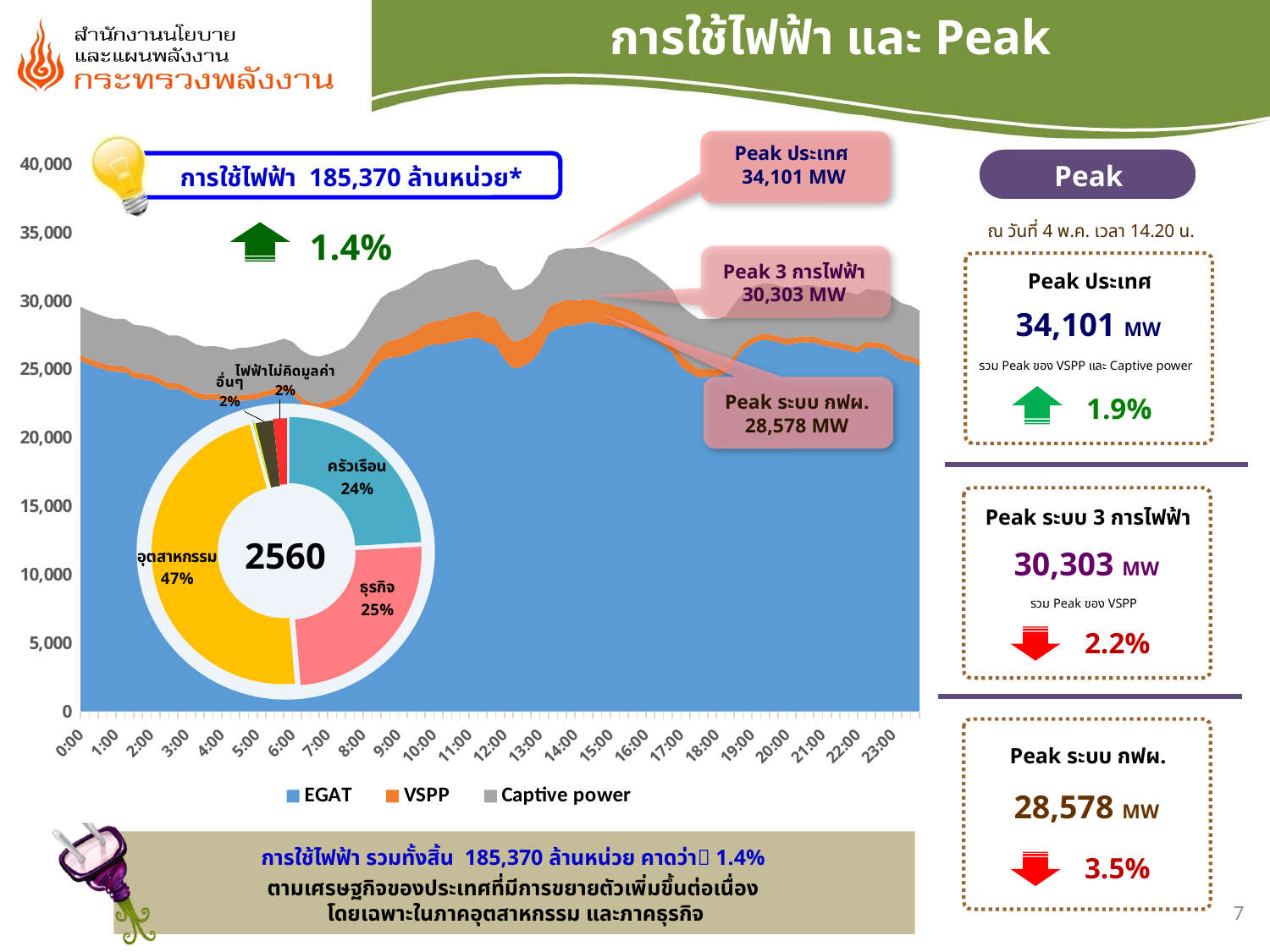
In the area chart, what is the value labelled for Peak 3 การไฟฟ้า? 30,303 MW In the donut chart labelled 2560, which category has the largest share? อุตสาหกรรม In the area chart, what is the difference between Peak ประเทศ and Peak ระบบ กฟผ.? 5,523 MW How many categories are shown in the donut chart labelled 2560? 5 In the area chart, which series is shown in orange according to the legend? VSPP How many series does the legend of the area chart list? 3 In the area chart, what is the value labelled for Peak ระบบ กฟผ.? 28,578 MW In the area chart, what is the value labelled for Peak ประเทศ? 34,101 MW In the area chart, is the EGAT value at 0:00 greater or less than 30,000? less What kind of chart is the large chart on the left showing values from 0:00 to 23:00? area chart In the donut chart labelled 2560, which is larger, ธุรกิจ or ครัวเรือน? ธุรกิจ In the donut chart labelled 2560, what is the share for ครัวเรือน? 24%